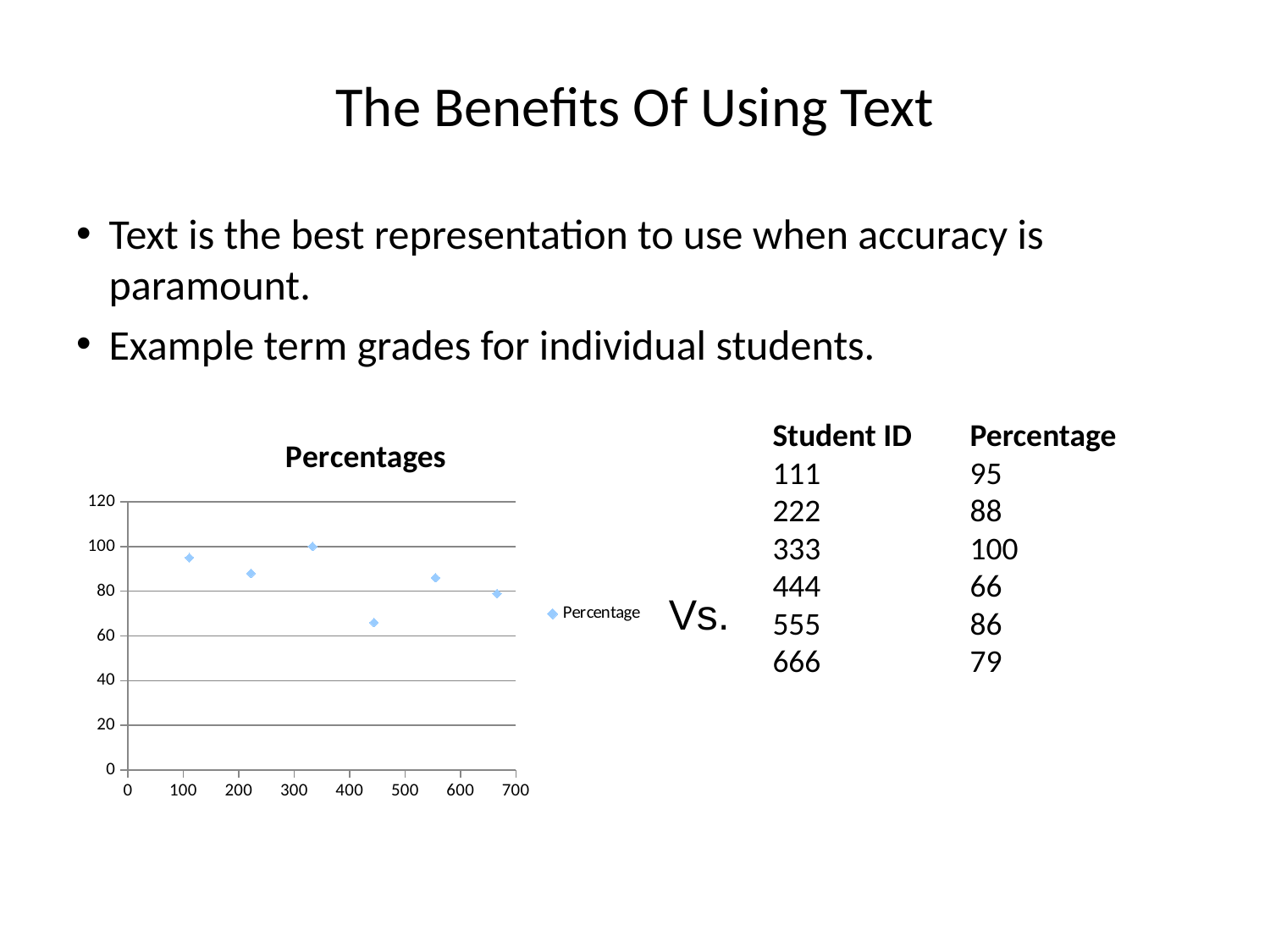
Which is larger, the value at x = 333 or the value at x = 444? x = 333 Is the value for the point at x = 111 greater or less than 80? greater What is the title of the chart? Percentages How many series does the chart legend list? 1 Which x value has the highest plotted point? 333 How many data points are plotted in the chart? 6 What is the plotted value for the point at x = 333? 100 What kind of chart is shown on the slide? scatter chart Which x value has the lowest plotted point? 444 What is the name of the series shown in the chart legend? Percentage Is the value for the point at x = 222 greater or less than 80? greater Is the value for the point at x = 444 greater or less than 80? less